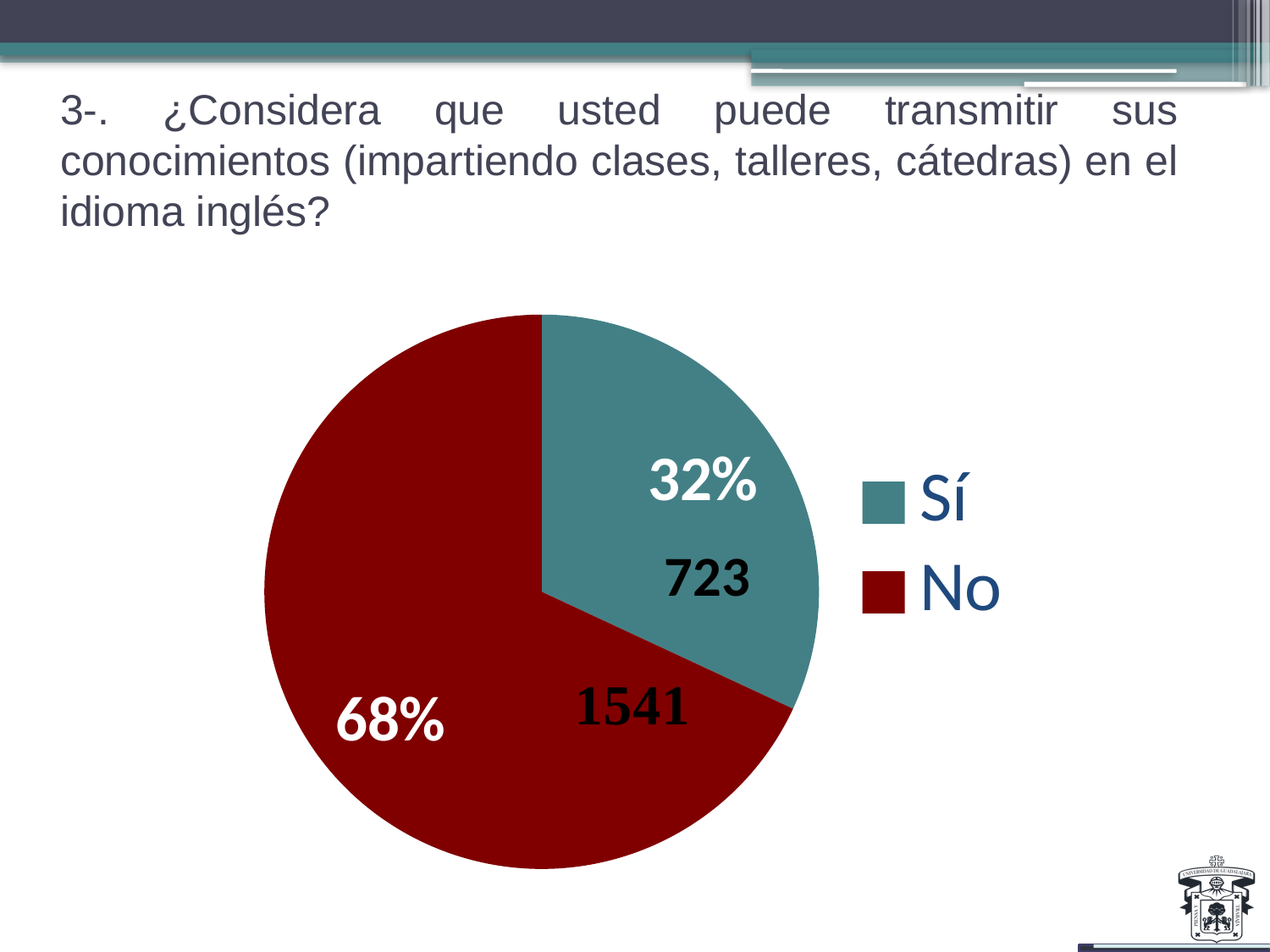
What is the count shown for the "No" slice? 1541 What percentage of the pie does the "No" slice represent? 68% Which category has the largest slice of the pie? No What is the count shown for the "Sí" slice? 723 Which category has the smallest slice of the pie? Sí What percentage of the pie does the "Sí" slice represent? 32% How many categories does the pie chart have? 2 What kind of chart is shown on the slide? pie chart What is the total of the counts shown on the pie chart? 2264 What colour is the "No" slice of the pie? dark red Which is larger, the count for "Sí" or the count for "No"? No What is the difference between the counts for "No" and "Sí"? 818